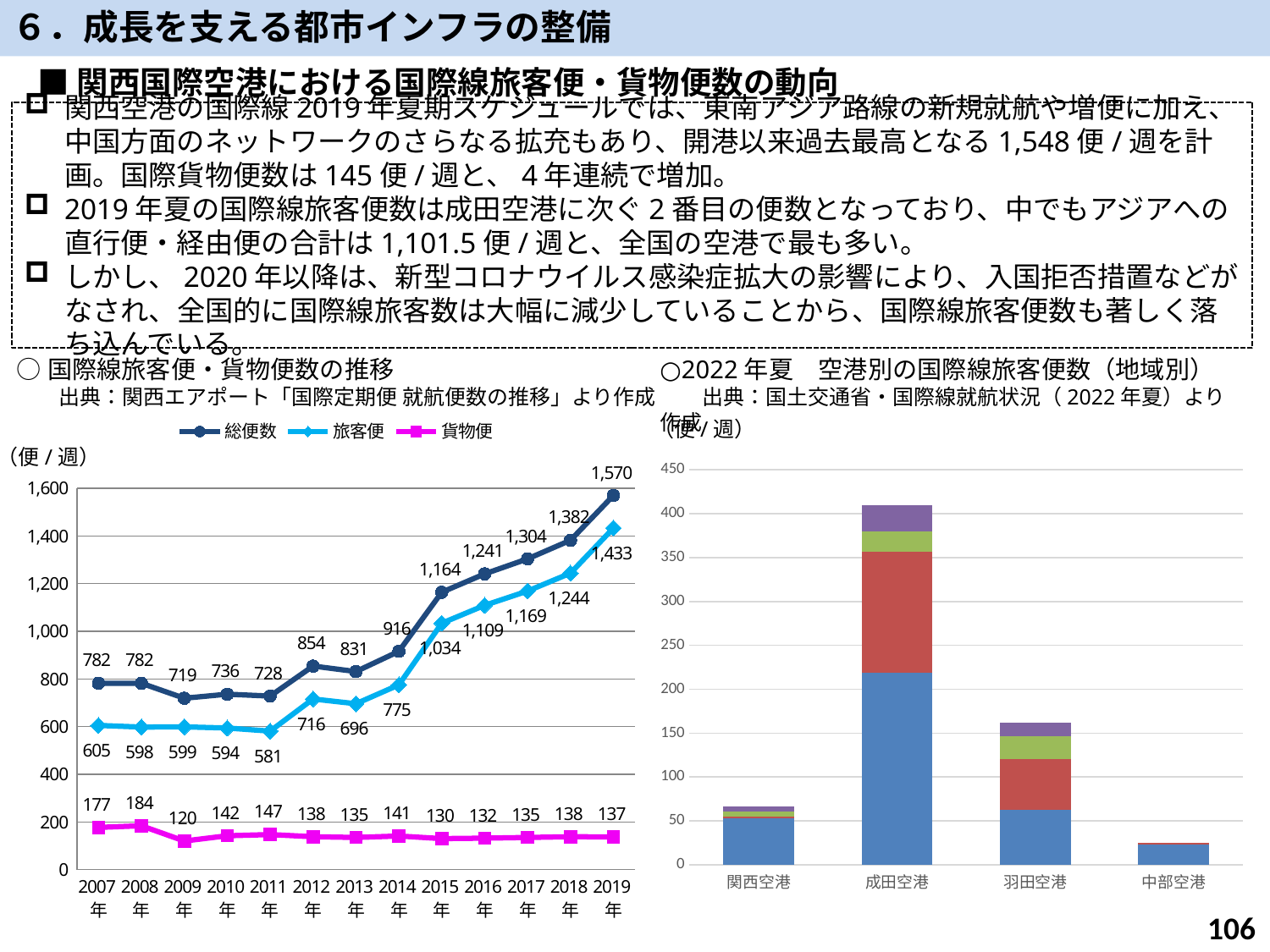
In the left chart (国際線旅客便・貨物便数の推移), does 総便数 generally rise or fall from 2013年 to 2019年? rise In the left chart (国際線旅客便・貨物便数の推移), what is the difference between 総便数 in 2019年 and 2018年? 188 In the left chart (国際線旅客便・貨物便数の推移), what is the value of 旅客便 for 2015年? 1,034 In the left chart (国際線旅客便・貨物便数の推移), which is larger: 旅客便 in 2012年 or 旅客便 in 2013年? 2012年 What kind of chart is the right chart (2022年夏 空港別の国際線旅客便数)? stacked bar chart In the left chart (国際線旅客便・貨物便数の推移), in which year is 貨物便 highest? 2008年 In the right chart (2022年夏 空港別の国際線旅客便数), is the total for 関西空港 greater or less than 100? less In the left chart (国際線旅客便・貨物便数の推移), what is the value of 貨物便 for 2009年? 120 In the left chart (国際線旅客便・貨物便数の推移), what is the value of 総便数 for 2019年? 1,570 In the left chart (国際線旅客便・貨物便数の推移), in which year is 旅客便 lowest? 2011年 In the right chart (2022年夏 空港別の国際線旅客便数), which airport has the tallest bar? 成田空港 In the left chart (国際線旅客便・貨物便数の推移), how many series does the legend list? 3